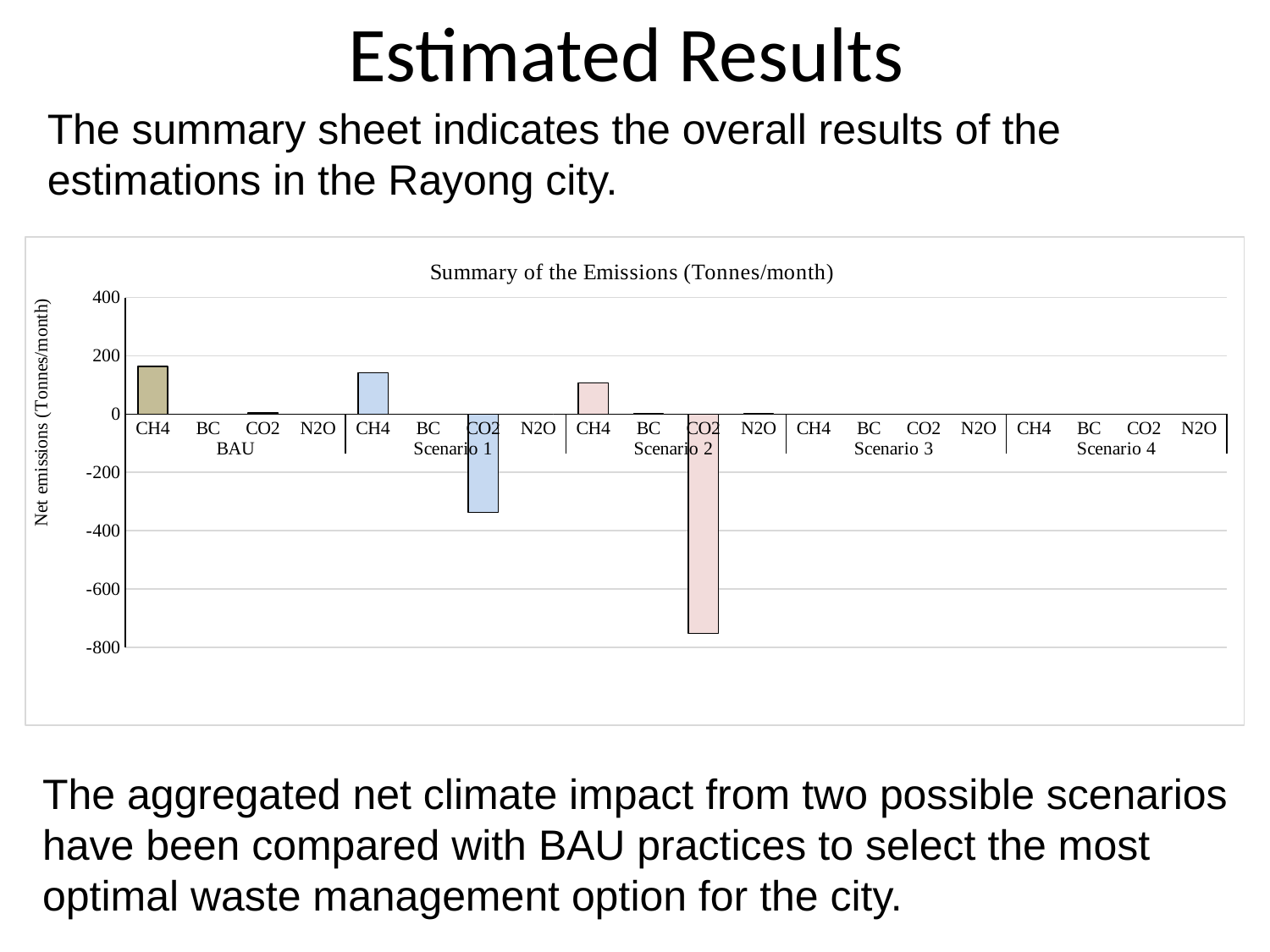
Which bar has the lowest (most negative) value in the chart? CO2 in Scenario 2 Which is larger, the CH4 value in BAU or the CH4 value in Scenario 2? CH4 in BAU How many scenario groups are shown along the x axis of the chart? 5 Is the value for CH4 in BAU greater or less than 200? less Which bar has the highest value in the chart? CH4 in BAU What is the title of the chart? Summary of the Emissions (Tonnes/month) Is the value for CO2 in Scenario 1 greater or less than -200? less What kind of chart is shown on the slide? bar chart Is the value for CH4 in Scenario 2 greater or less than 200? less What is the label on the vertical axis of the chart? Net emissions (Tonnes/month) Does the CH4 value rise or fall going from BAU to Scenario 1 to Scenario 2? fall